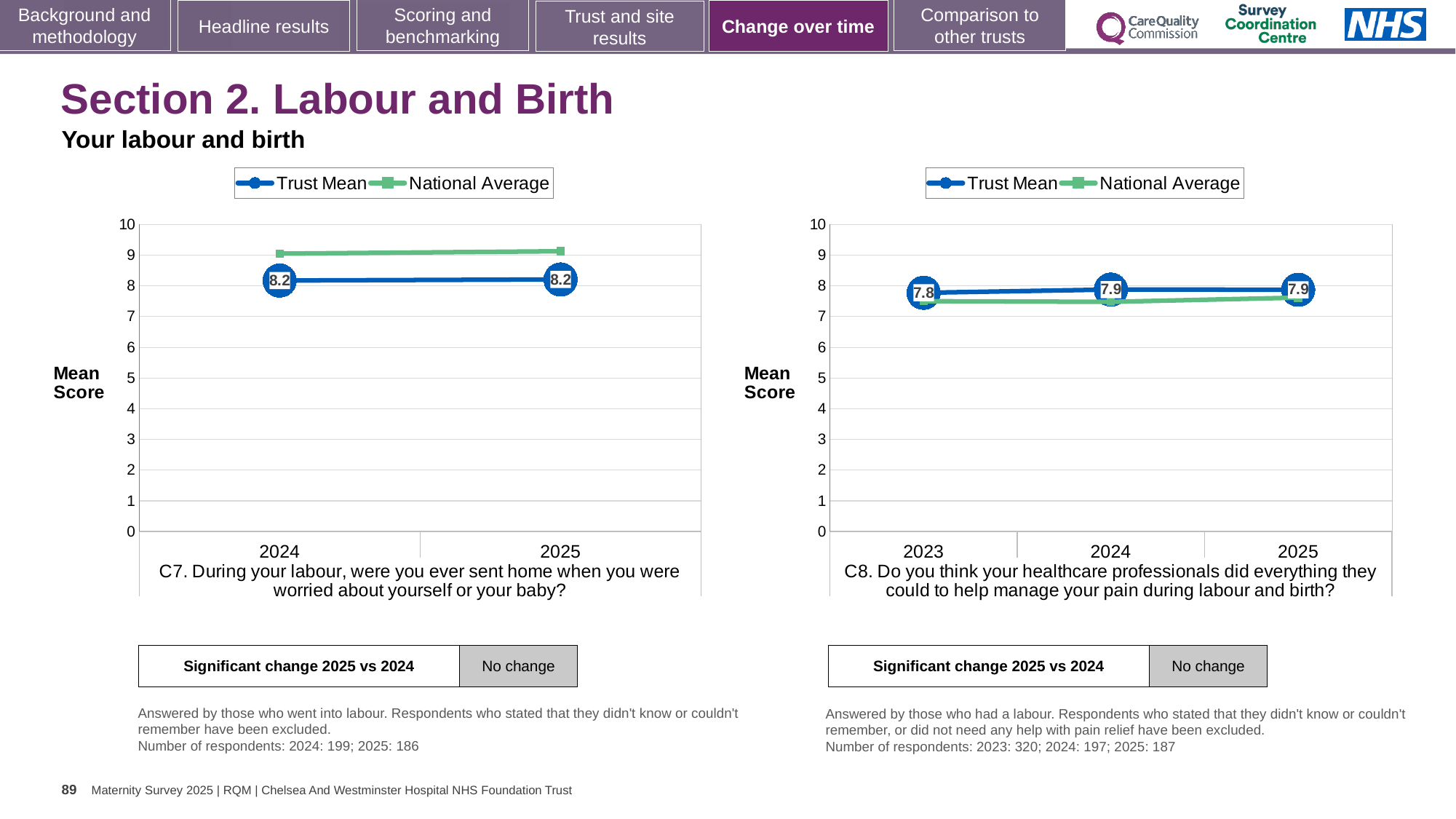
In the C8 chart on the right, what is the Trust Mean for 2025? 7.9 In the C7 chart on the left, is the National Average for 2024 greater or less than 8? greater In the C7 chart on the left, which series is higher in 2025, Trust Mean or National Average? National Average In the C7 chart on the left, how many years are plotted on the x axis? 2 In the C7 chart on the left, what is the Trust Mean for 2024? 8.2 In the C8 chart on the right, what is the Trust Mean for 2023? 7.8 In the C8 chart on the right, is the National Average for 2023 greater or less than 8? less In the C8 chart on the right, how many years are plotted on the x axis? 3 In the C7 chart on the left, what is the Trust Mean for 2025? 8.2 What kind of chart is the C8 chart on the right? Line chart In the C8 chart on the right, what is the difference between the Trust Mean for 2025 and the Trust Mean for 2023? 0.1 In the C7 chart on the left, how many series does the legend list? 2